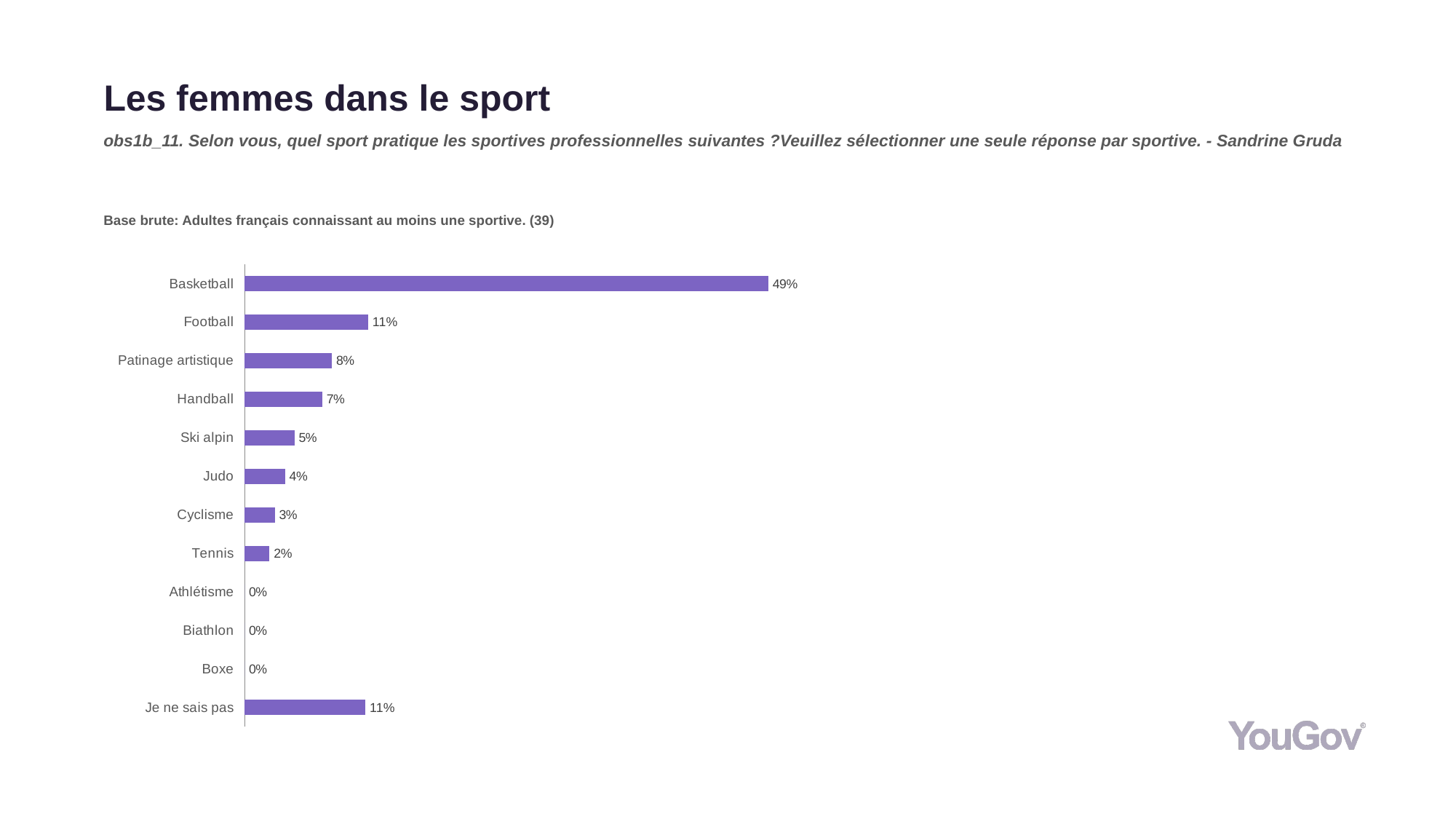
What is the difference between the values for Handball and Ski alpin? 2% What kind of chart is shown on the slide? Bar chart Which category has the highest value? Basketball What is the value shown for Patinage artistique? 8% How many categories have a value of 0%? 3 What is the value shown for Tennis? 2% What is the difference between the values for Basketball and Football? 38% What is the value shown for Je ne sais pas? 11% Which is larger, the value for Judo or the value for Cyclisme? Judo What percentage of respondents answered Basketball? 49% How many categories are shown on the chart? 12 What is the title of the slide? Les femmes dans le sport